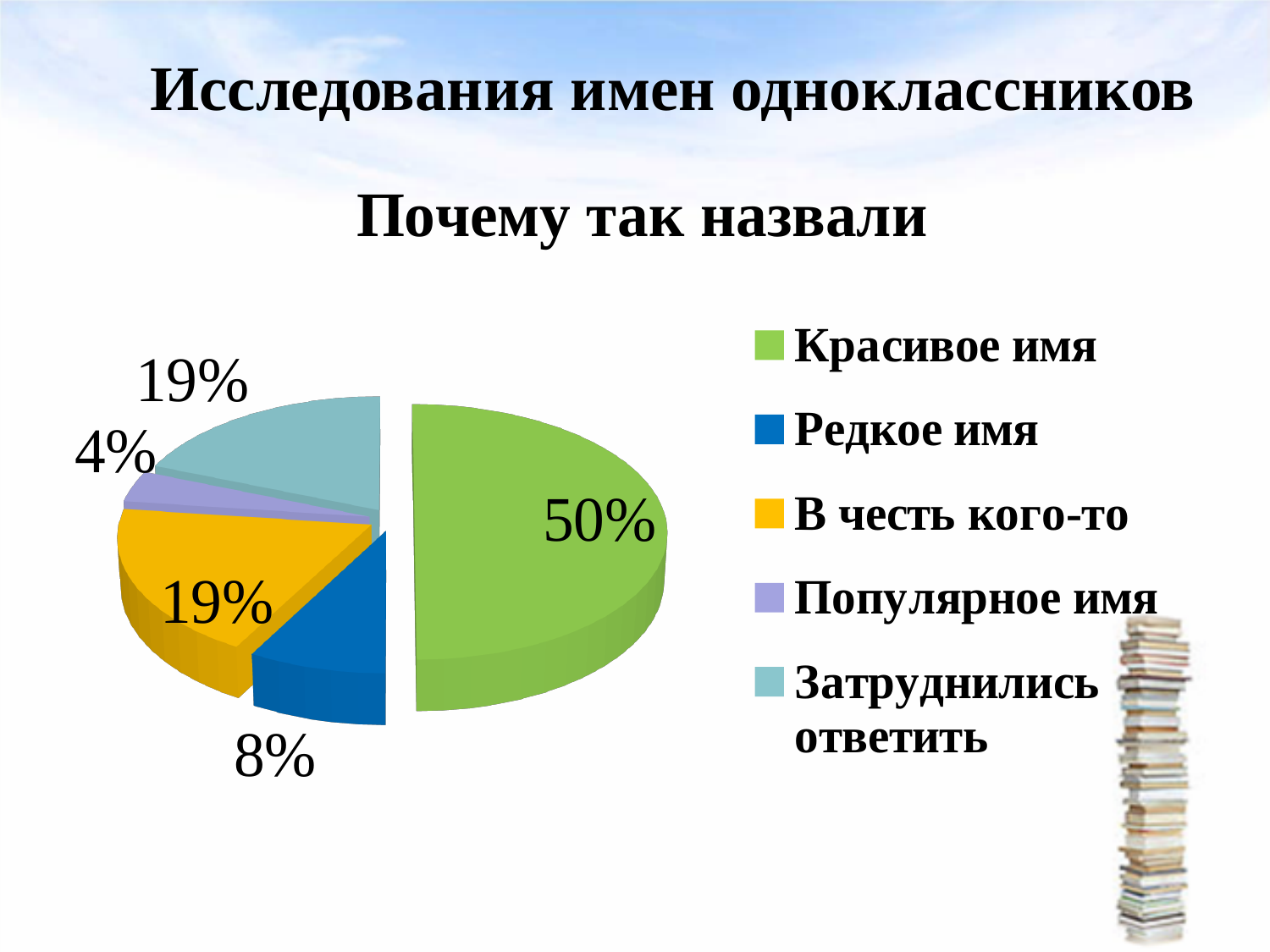
Which category has the largest share of the pie? Красивое имя Which category has the smallest share of the pie? Популярное имя What is the value for "Затруднились ответить"? 19% What is the value for "В честь кого-то"? 19% What is the title of the chart? Почему так назвали How many categories does the legend list? 5 What is the difference between the shares of "Красивое имя" and "Редкое имя"? 42% What is the value for "Редкое имя"? 8% What share of the pie does "Красивое имя" have? 50% What kind of chart is shown on the slide? pie chart Which is larger, the share for "Редкое имя" or the share for "Популярное имя"? Редкое имя What is the value for "Популярное имя"? 4%